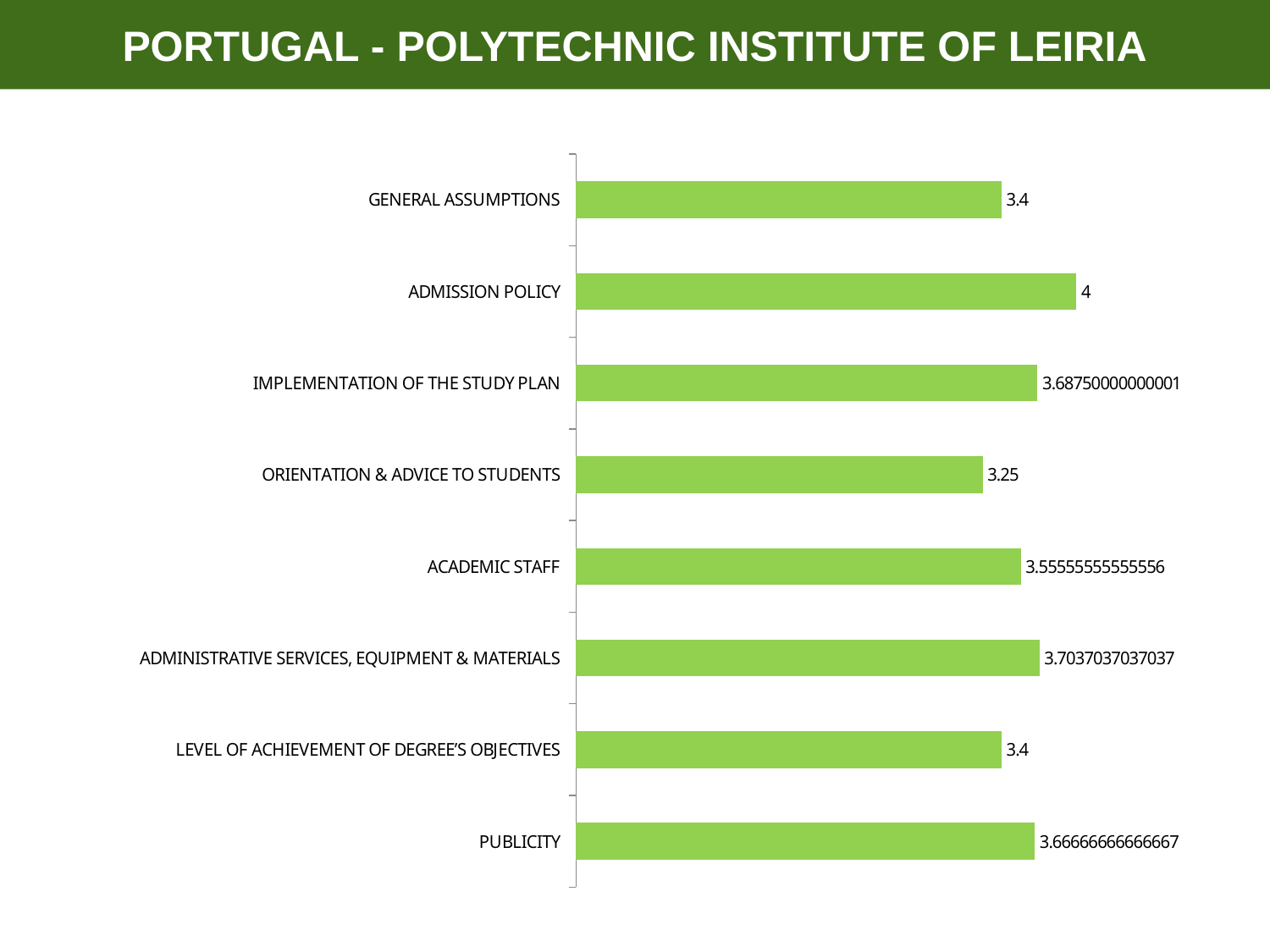
What is the value for PUBLICITY? 3.66666666666667 How many categories are shown in the chart? 8 What is the difference between the values for ADMISSION POLICY and ORIENTATION & ADVICE TO STUDENTS? 0.75 Which is larger, the value for ACADEMIC STAFF or the value for ORIENTATION & ADVICE TO STUDENTS? ACADEMIC STAFF What is the value for GENERAL ASSUMPTIONS? 3.4 Which category has the highest value? ADMISSION POLICY What kind of chart is shown on the slide? Bar chart What is the value for ADMISSION POLICY? 4 What is the value for ACADEMIC STAFF? 3.55555555555556 What is the difference between the values for ADMISSION POLICY and GENERAL ASSUMPTIONS? 0.6 What is the value for ORIENTATION & ADVICE TO STUDENTS? 3.25 Which category has the lowest value? ORIENTATION & ADVICE TO STUDENTS